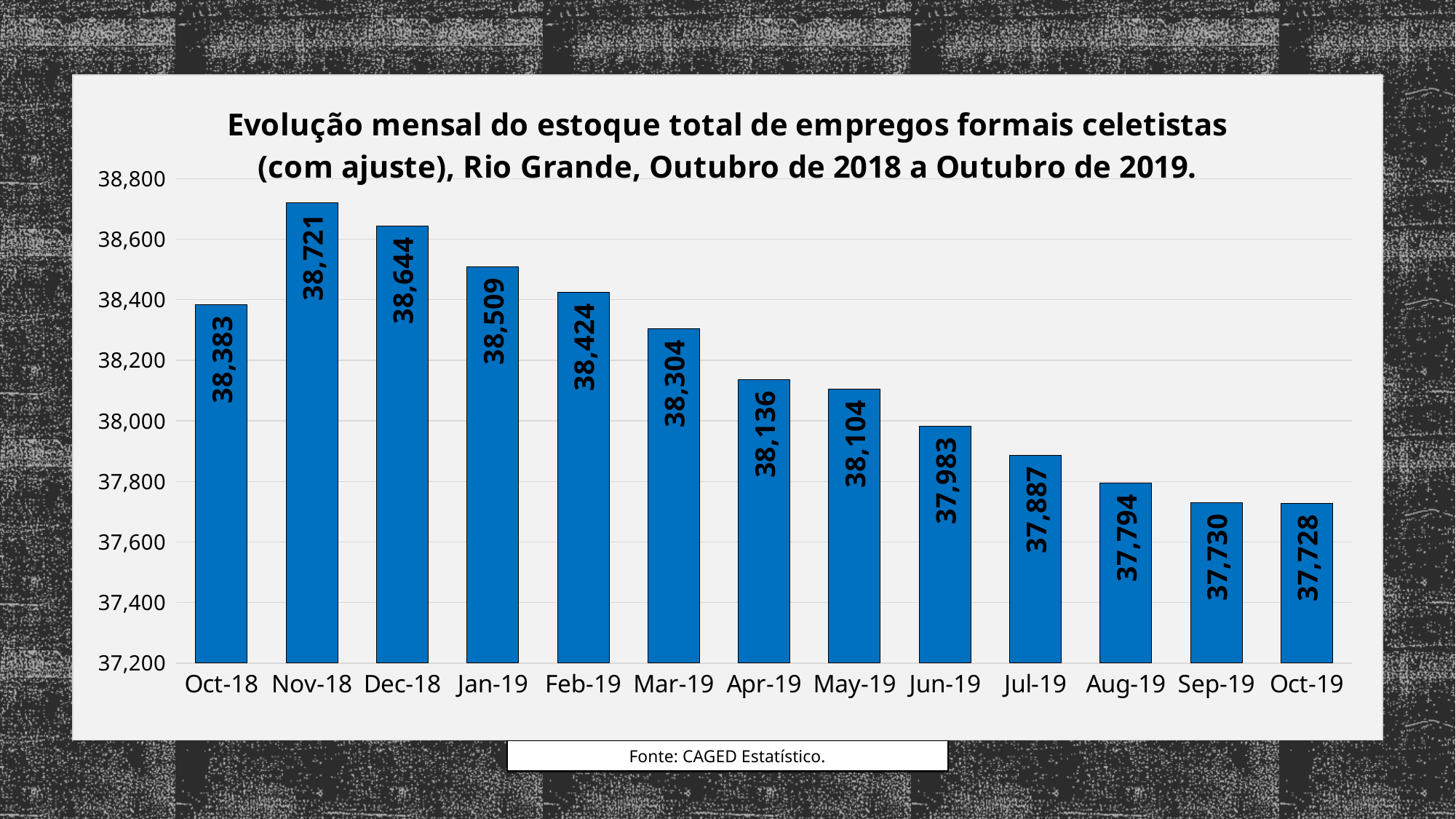
Which month has the highest value? Nov-18 What is the difference between the values for Nov-18 and Oct-19? 993 What is the value for Jun-19? 37,983 What is the value for Nov-18? 38,721 What kind of chart is this? Bar chart Which is larger, the value for Oct-18 or the value for Jan-19? Jan-19 Which month has the lowest value? Oct-19 Is the value for Mar-19 greater or less than 38,200? greater What source is cited below the chart? CAGED Estatístico How many months are shown on the x axis? 13 From Nov-18 to Oct-19, do the values rise or fall? Fall What is the value for Oct-19? 37,728